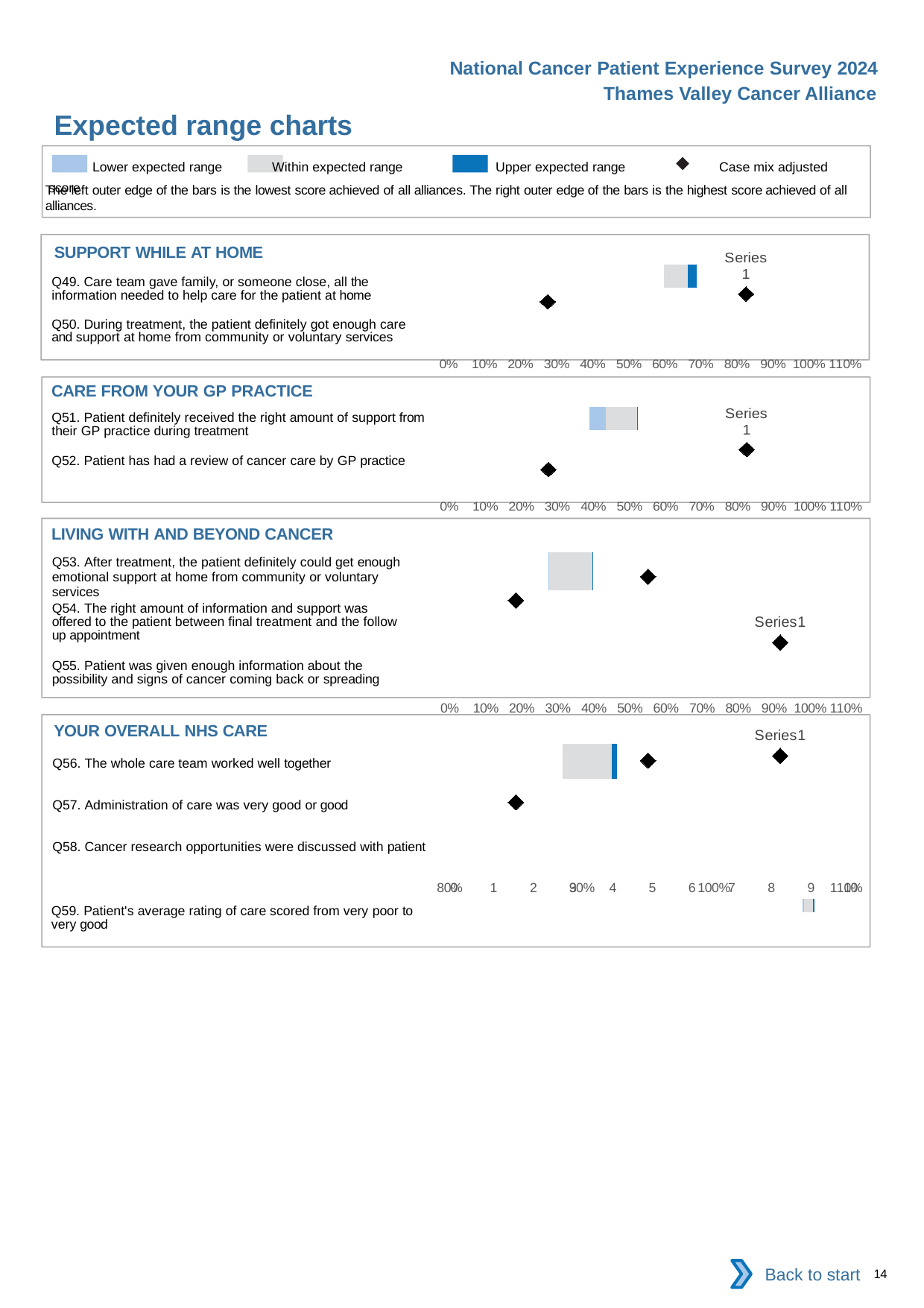
How many questions are listed in the LIVING WITH AND BEYOND CANCER section? 3 In the CARE FROM YOUR GP PRACTICE chart, is the right edge of the shaded expected range bar greater or less than 70%? less Which legend entry is represented by a black diamond marker? Case mix adjusted score In the CARE FROM YOUR GP PRACTICE chart, is the left edge of the shaded expected range bar greater or less than 30%? greater In the LIVING WITH AND BEYOND CANCER chart, is the right edge of the shaded expected range bar greater or less than 50%? less How many questions are listed in the SUPPORT WHILE AT HOME section? 2 How many questions are listed in the YOUR OVERALL NHS CARE section? 4 What is the highest tick label shown on the x axis of the CARE FROM YOUR GP PRACTICE chart? 110% How many entries does the legend at the top of the slide list? 4 What kind of chart is used in the SUPPORT WHILE AT HOME section? bar chart